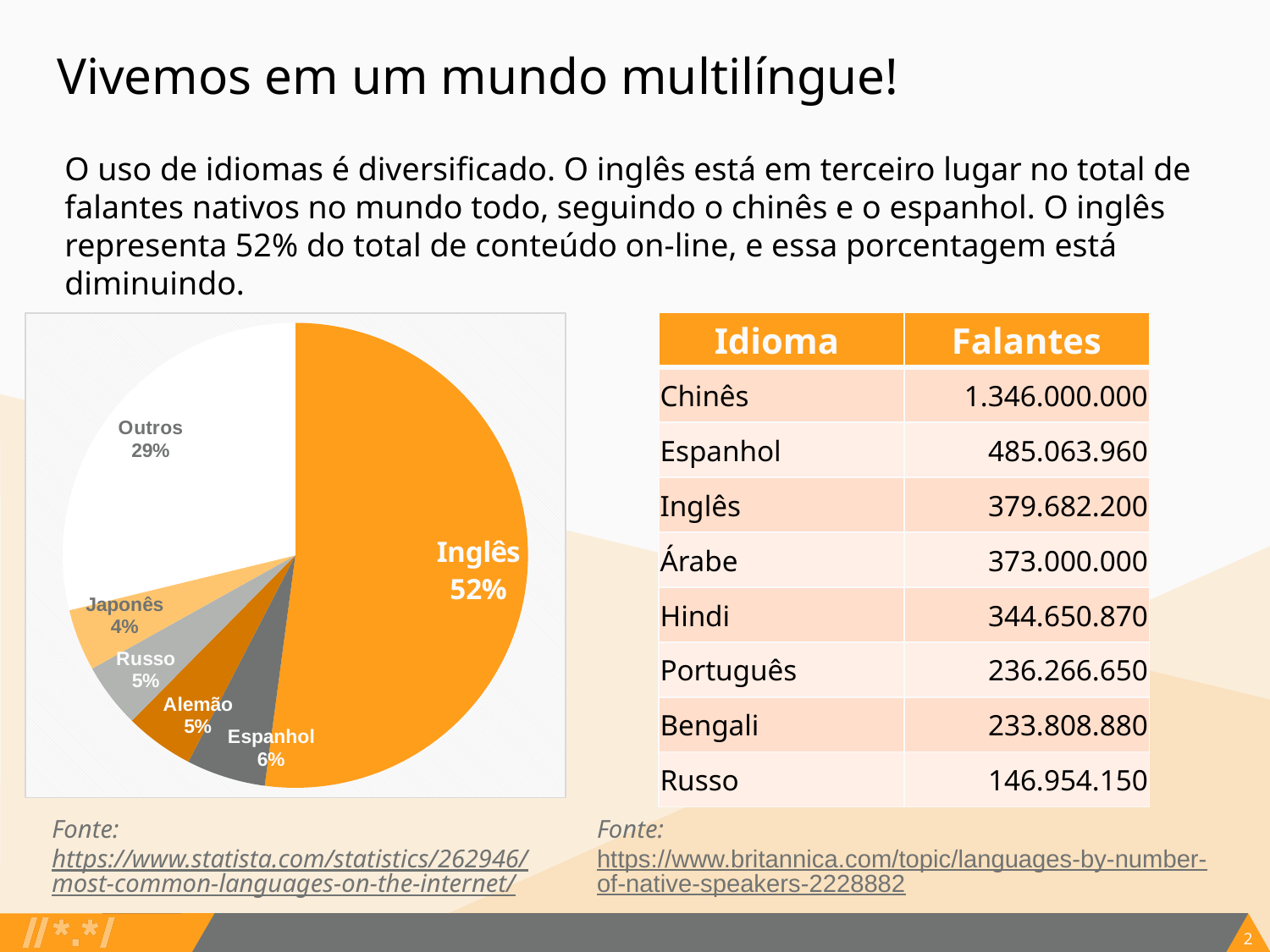
What share of the pie does Espanhol represent? 6% How many slices does the pie chart have? 6 Which slice of the pie chart is the largest? Inglês What share of the pie does Inglês represent? 52% What colour is the Inglês slice of the pie chart? orange What share of the pie does Japonês represent? 4% Which slice of the pie chart is the smallest? Japonês What share of the pie does Russo represent? 5% What is the difference in percentage points between the Inglês slice and the Outros slice? 23 What kind of chart is shown on the slide? pie chart Which slice is larger, Espanhol or Alemão? Espanhol What share of the pie does Outros represent? 29%